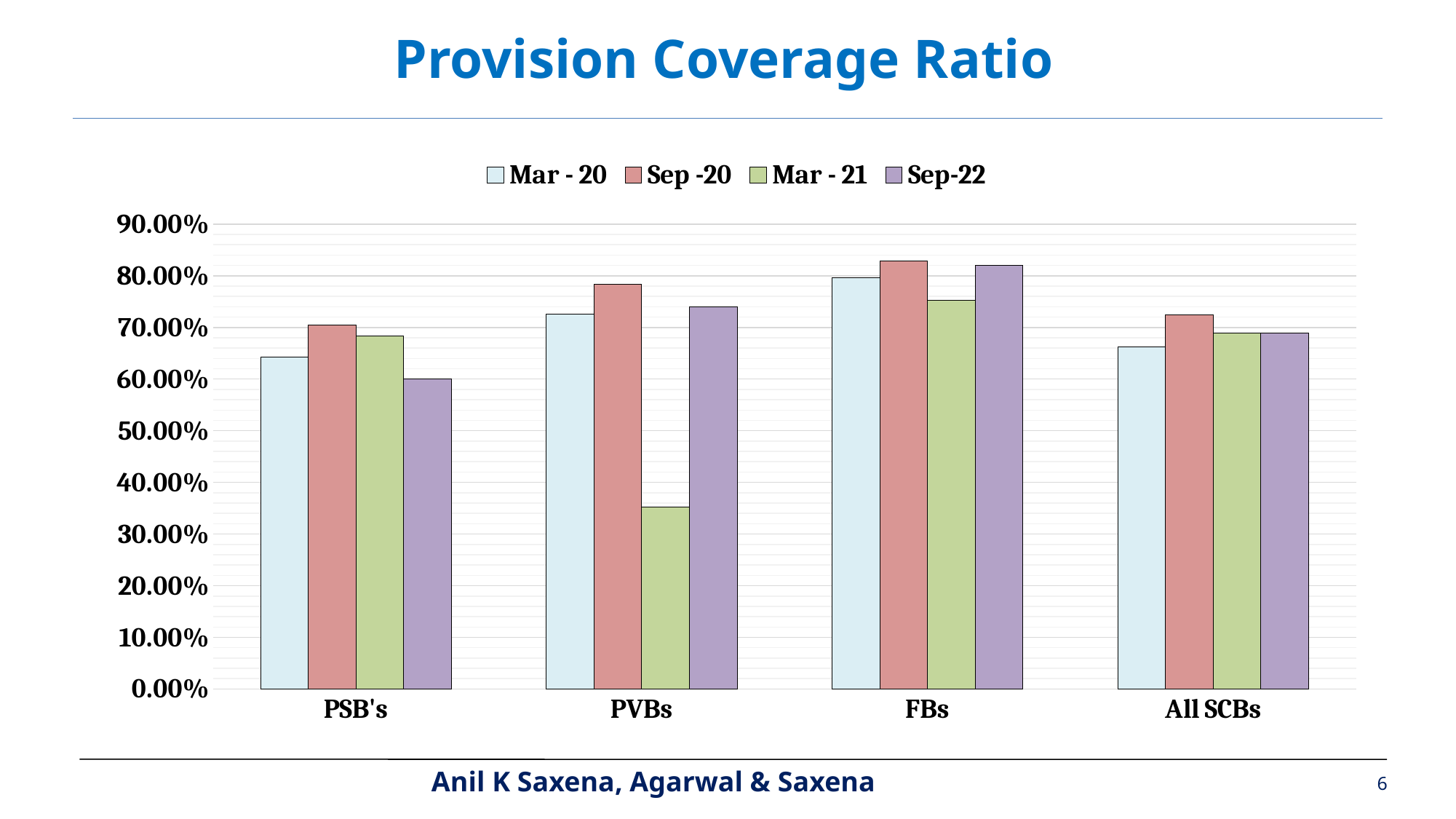
Which category and series has the highest bar in the chart? Sep -20 for FBs Which category and series has the lowest bar in the chart? Mar - 21 for PVBs Which category has the highest Mar - 20 value? FBs For FBs, which is larger: the Mar - 21 value or the Sep-22 value? Sep-22 Is the Mar - 21 value for PVBs greater or less than 40.00%? less What is the title of the chart? Provision Coverage Ratio Is the Sep -20 value for FBs greater or less than 80.00%? greater What kind of chart is shown on the slide? Bar chart How many series does the legend list? 4 Is the Sep-22 value for PSB's greater or less than 70.00%? less For PSB's, which is larger: the Mar - 20 value or the Sep -20 value? Sep -20 How many categories are shown on the x axis? 4